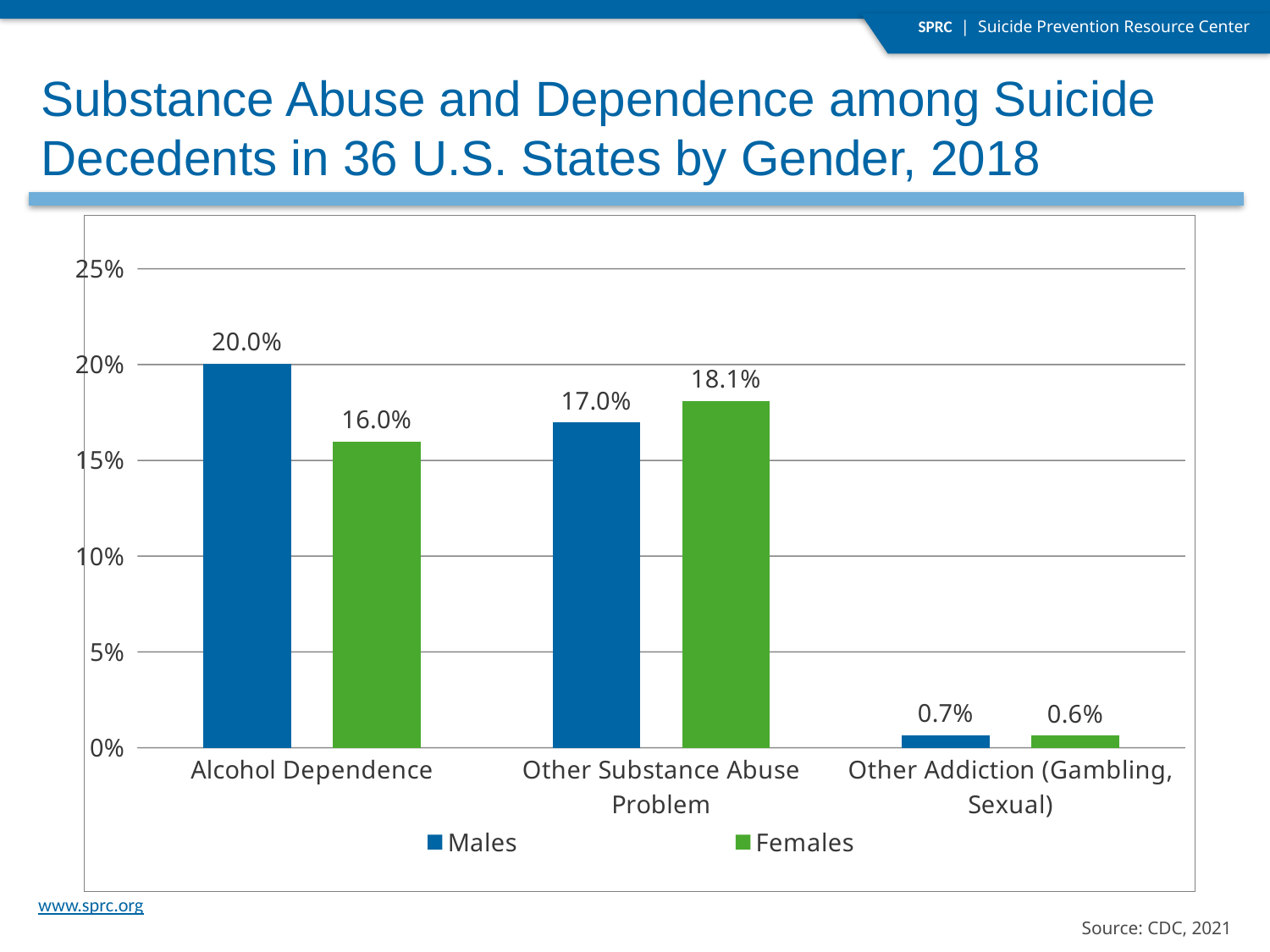
What is the value for Females in the Other Substance Abuse Problem category? 18.1% Is the value for Females in the Other Substance Abuse Problem category greater or less than 15%? greater Which category has the highest value for Males? Alcohol Dependence Which category has the lowest value for Females? Other Addiction (Gambling, Sexual) What is the value for Females in the Alcohol Dependence category? 16.0% What is the value for Males in the Other Addiction (Gambling, Sexual) category? 0.7% What is the value for Males in the Alcohol Dependence category? 20.0% What kind of chart is shown on the slide? Bar chart Which is larger for Other Substance Abuse Problem, the Males value or the Females value? Females How many categories are shown on the x axis? 3 What is the difference between the Males and Females values for Alcohol Dependence? 4.0% How many series does the legend list? 2